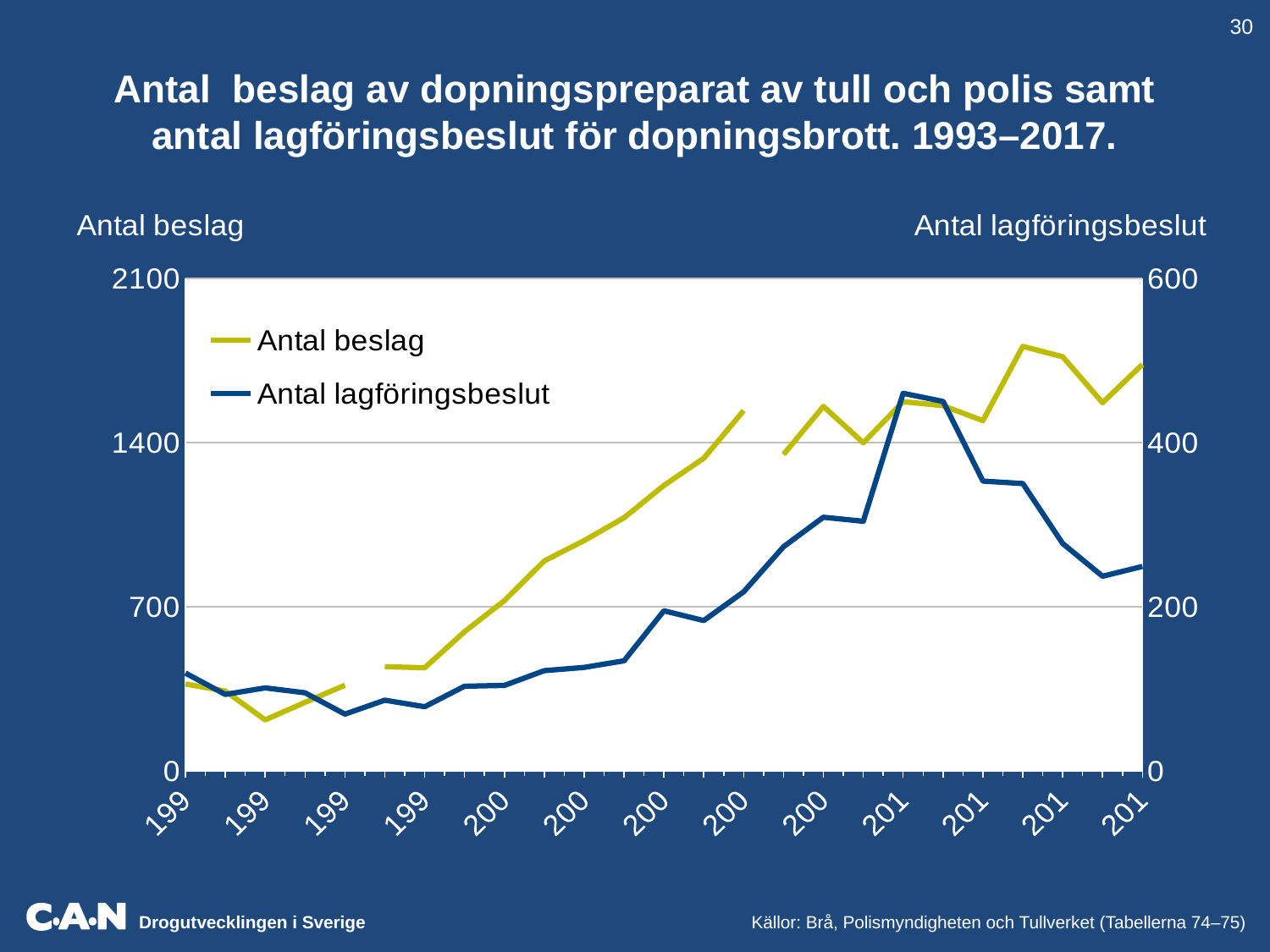
Is the last point of the Antal lagföringsbeslut line greater or less than 400 on the right-hand axis? less Is the highest point of the Antal lagföringsbeslut line greater or less than 400 on the right-hand axis? greater Is the last point of the Antal beslag line greater or less than 1400? greater After reaching its peak, does the Antal lagföringsbeslut line rise or fall towards the end of the period? fall How many series does the legend list? 2 What is the highest tick value shown on the left-hand axis? 2100 Which series is plotted against the right-hand axis labelled 'Antal lagföringsbeslut'? Antal lagföringsbeslut What kind of chart is shown on the slide? line chart Does the Antal beslag line overall rise or fall from the start of the period to the end? rise